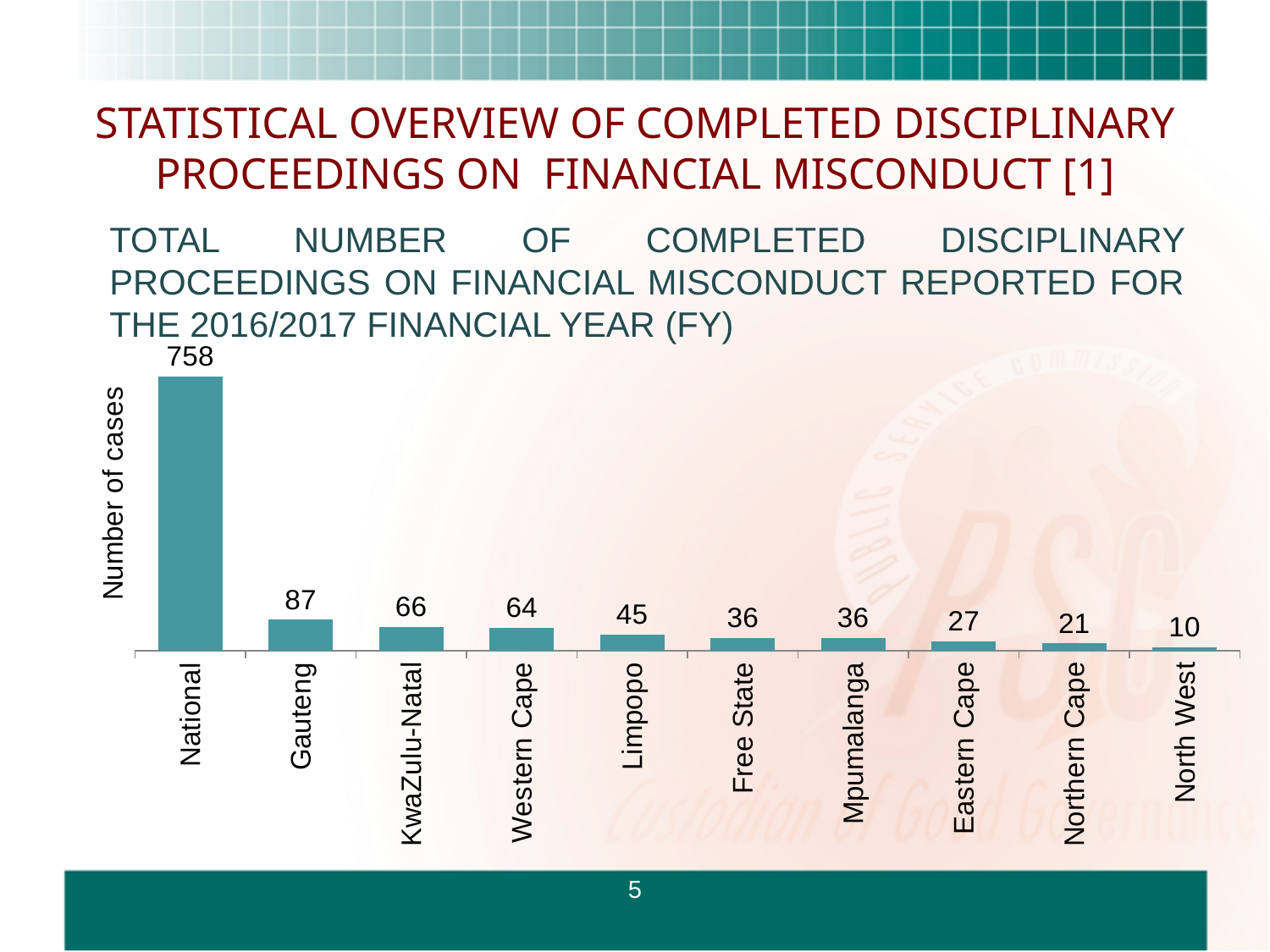
Which category has the lowest number of cases? North West What is the number of cases for Limpopo? 45 What kind of chart is shown on the slide? Bar chart Which has more cases, Western Cape or Eastern Cape? Western Cape What is the number of cases for Northern Cape? 21 What is the difference in number of cases between Gauteng and KwaZulu-Natal? 21 Which category has the highest number of cases? National What is the difference in number of cases between National and Gauteng? 671 How many categories are shown on the x axis? 10 What is the label of the vertical axis? Number of cases What is the number of cases for Gauteng? 87 Do the values rise or fall from left to right along the x axis? Fall